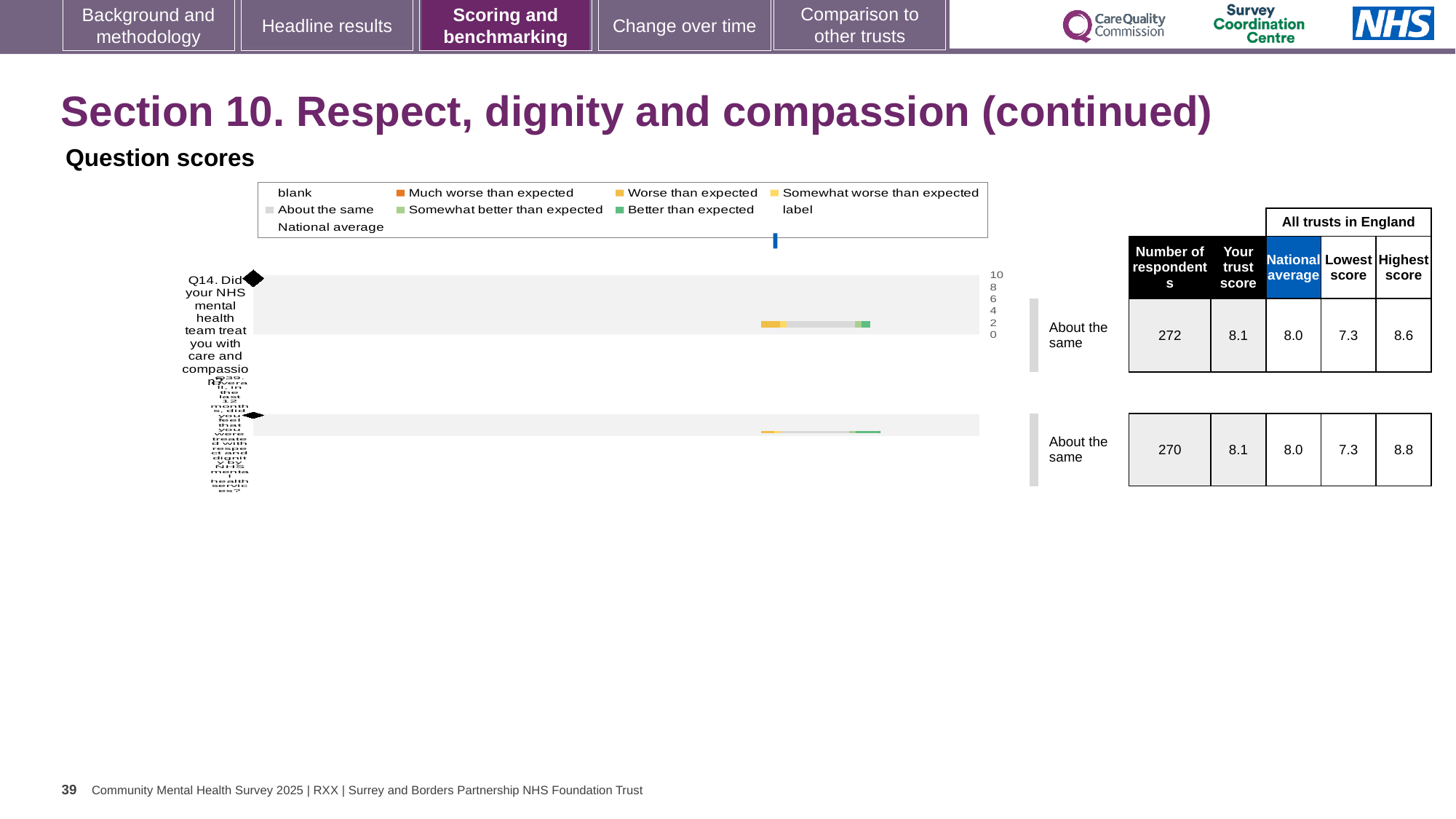
What is the maximum value shown on the score axis of the chart? 10 How many survey questions are plotted in the chart? 2 What kind of chart is used to show the question scores? bar chart What is the national average score for Q14? 8.0 Which question had more respondents, Q14 or Q39? Q14 What is the trust score for Q14? 8.1 What is the difference between the highest score for Q39 and the highest score for Q14? 0.2 What is the highest score among all trusts in England for Q39? 8.8 How many respondents answered Q14? 272 What benchmark category is shown next to the Q14 bar? About the same What is the highest score among all trusts in England for Q14? 8.6 How many respondents answered Q39? 270